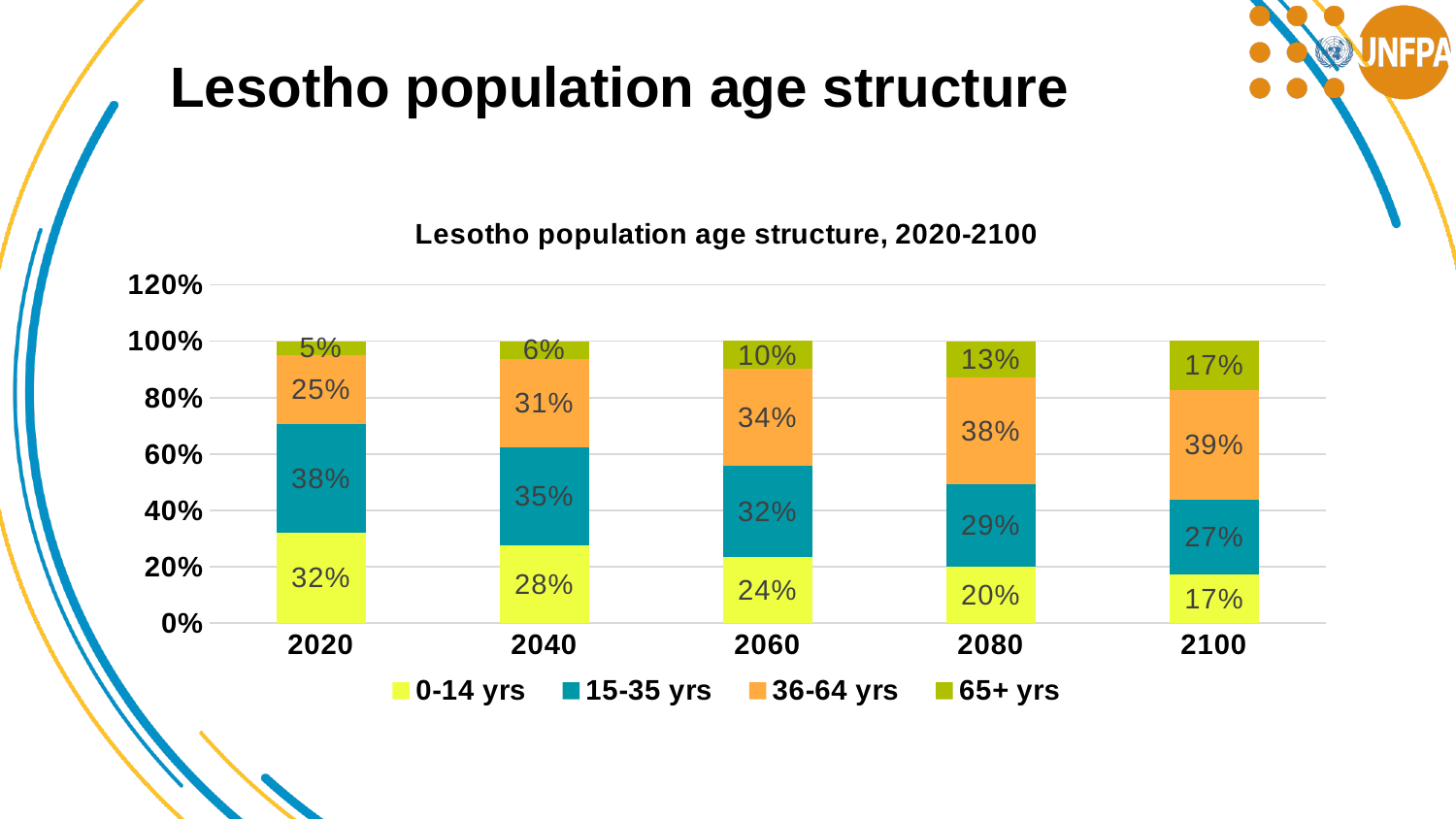
How many years are shown on the x axis? 5 What is the value for the 65+ yrs series in 2100? 17% Does the 0-14 yrs share rise or fall from 2020 to 2100? Fall What is the title of the chart? Lesotho population age structure, 2020-2100 In which year is the 65+ yrs share lowest? 2020 What is the value for the 0-14 yrs series in 2020? 32% What is the value for the 36-64 yrs series in 2060? 34% In which year is the 0-14 yrs share highest? 2020 Which is larger in 2080: the 15-35 yrs value or the 36-64 yrs value? 36-64 yrs How many series does the legend list? 4 What is the difference between the 36-64 yrs value in 2100 and in 2020? 14% What kind of chart is shown? Stacked bar chart